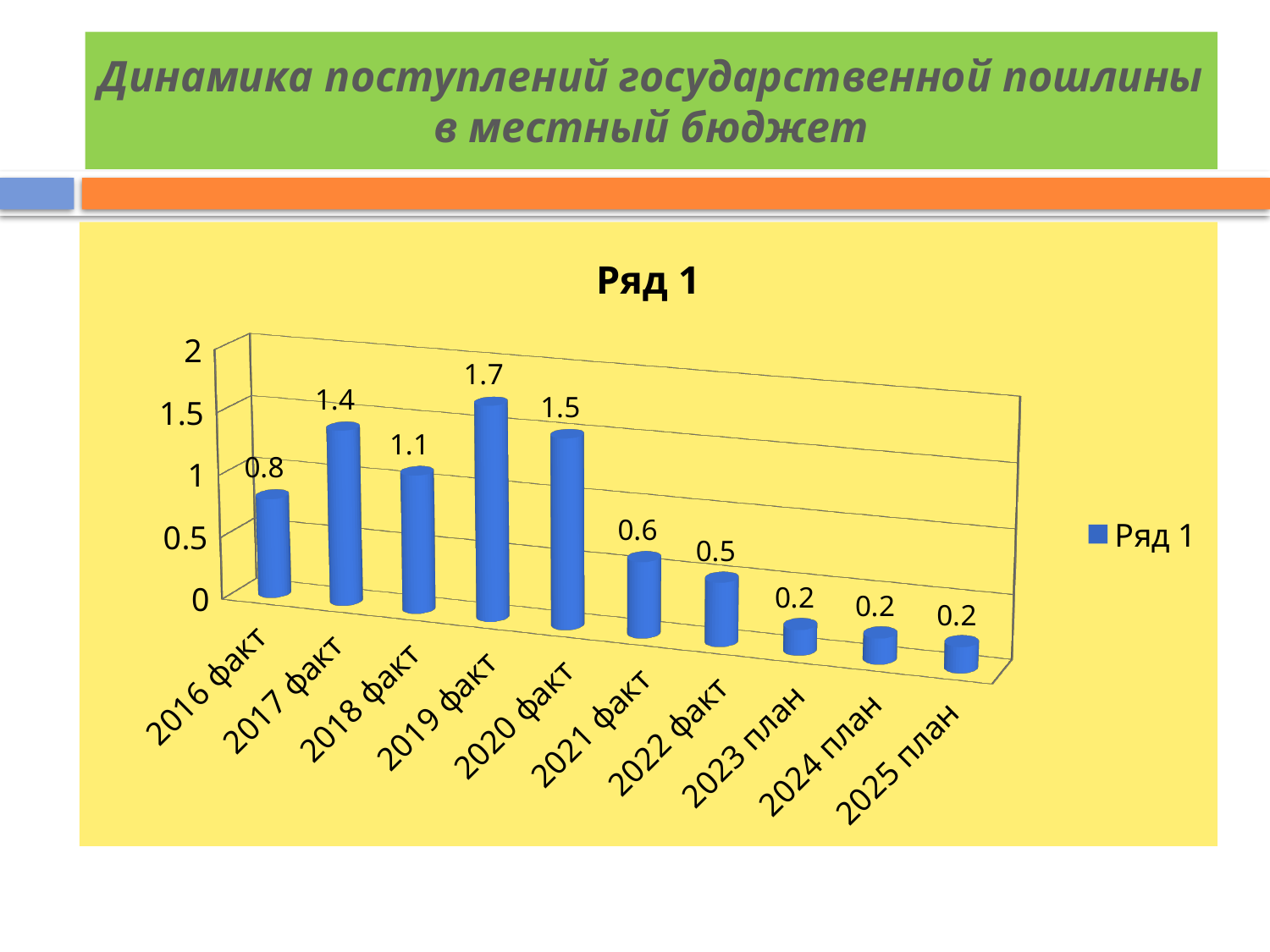
What is the value for 2016 факт? 0.8 What is the difference between the values for 2017 факт and 2018 факт? 0.3 Do the values rise or fall from 2020 факт to 2025 план? fall How many series does the legend list? 1 What is the difference between the values for 2019 факт and 2020 факт? 0.2 Which category has the highest value? 2019 факт What is the name of the series shown in the legend? Ряд 1 What is the value for 2019 факт? 1.7 What kind of chart is shown on the slide? bar chart Which is larger, the value for 2021 факт or the value for 2022 факт? 2021 факт What is the value for 2022 факт? 0.5 How many categories are shown on the x axis? 10